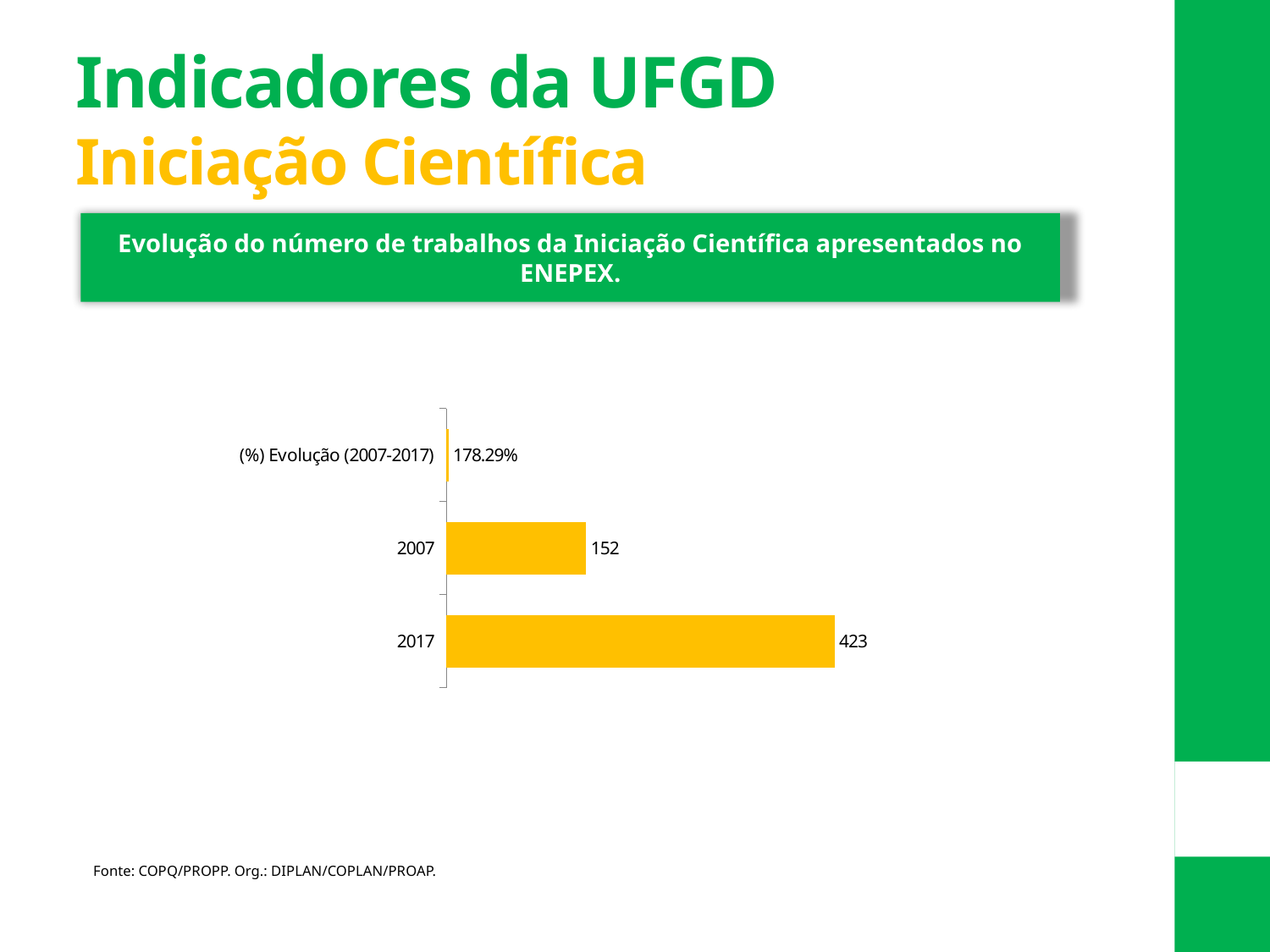
What colour are the bars in the chart? Yellow What is the value for 2017? 423 Which year has the higher number of works, 2007 or 2017? 2017 What is the title of the chart on the slide? Evolução do número de trabalhos da Iniciação Científica apresentados no ENEPEX. What kind of chart is shown on the slide? Bar chart What is the value shown for (%) Evolução (2007-2017)? 178.29% What is the difference between the values for 2017 and 2007? 271 How many bars are plotted in the chart? 3 Which category has the largest bar in the chart? 2017 What is the value for 2007? 152